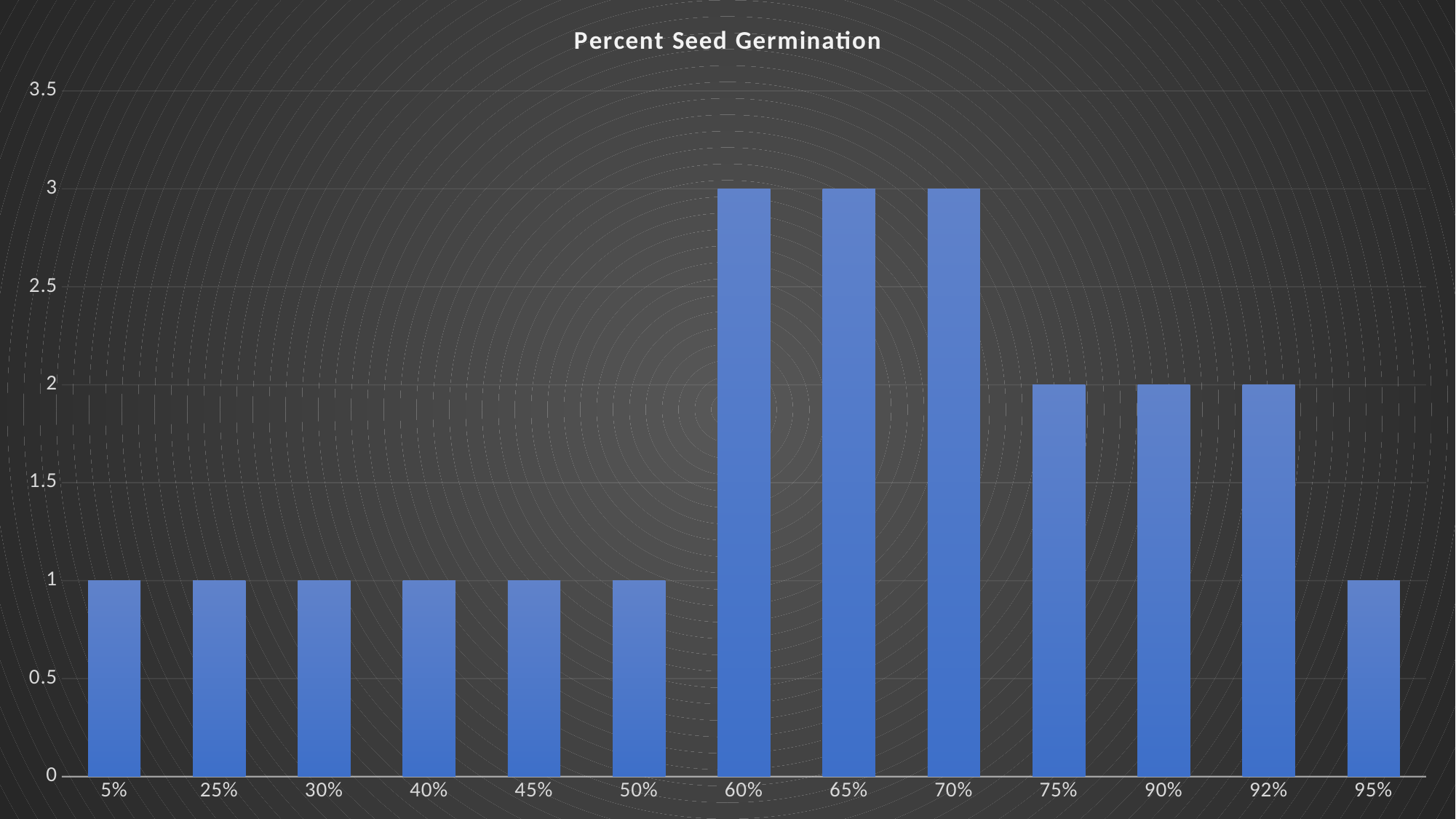
What is the title of the chart? Percent Seed Germination What is the difference between the value for 92% and the value for 5%? 1 Is the value for 45% greater or less than 2? less What is the value for the 75% category? 2 How many categories are shown on the x axis of the chart? 13 What is the value for the 40% category? 1 What type of chart is shown on the slide? bar chart What is the value for the 60% category? 3 How many categories have a value of 3? 3 Which is larger, the value for 70% or the value for 90%? 70% What is the value for the 95% category? 1 What is the difference between the value for 65% and the value for 50%? 2